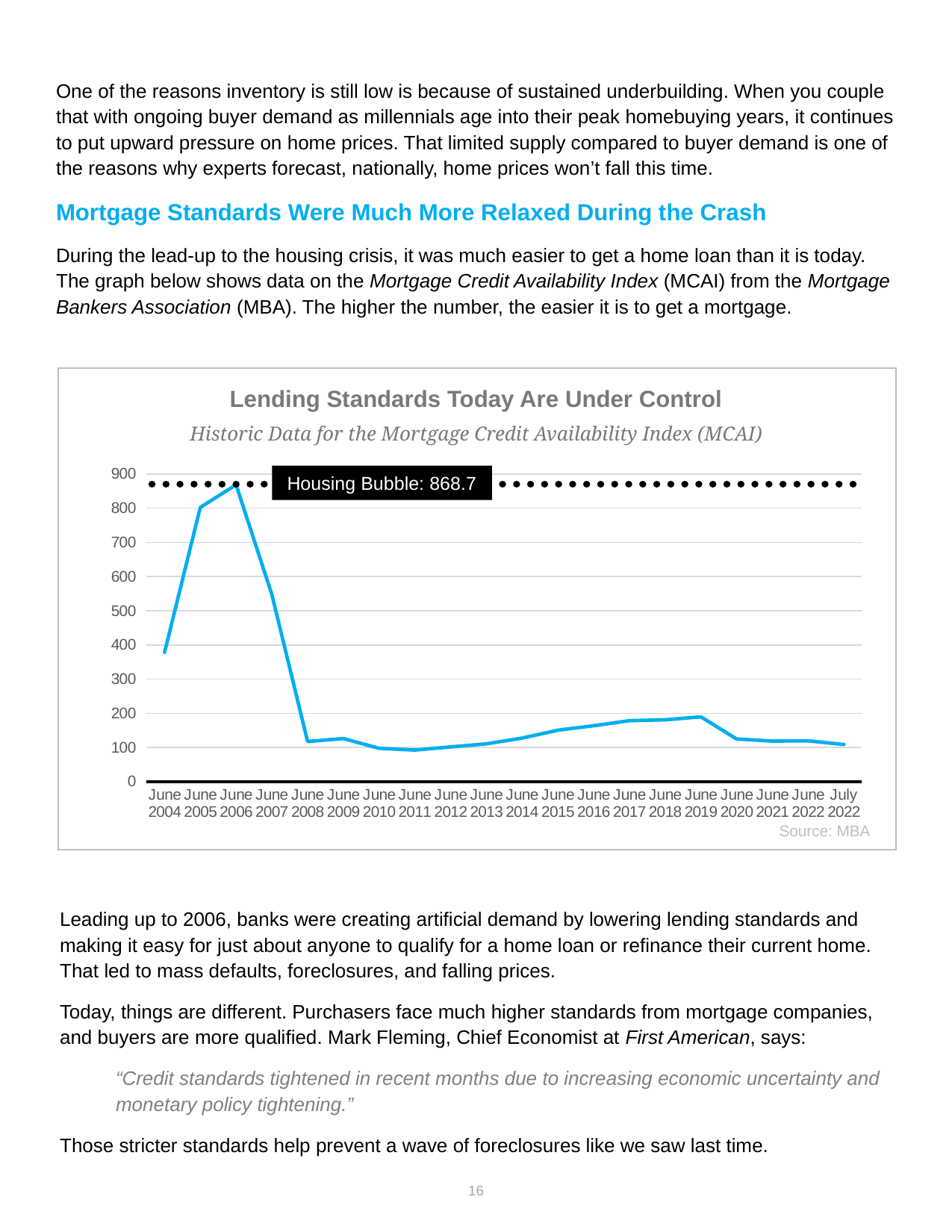
What is the title of the chart? Lending Standards Today Are Under Control Is the value for June 2005 greater or less than 700? greater What value is labeled for the Housing Bubble on the chart? 868.7 Is the value for June 2008 greater or less than 200? less What source is cited for the chart data? MBA Does the MCAI rise or fall between June 2006 and June 2008? Fall Is the value for July 2022 greater or less than 200? less Which is larger, the value for June 2006 or the value for June 2019? June 2006 What type of chart is shown on the slide? Line chart How many data points are plotted along the x axis? 20 In which period does the MCAI reach its highest value? June 2006